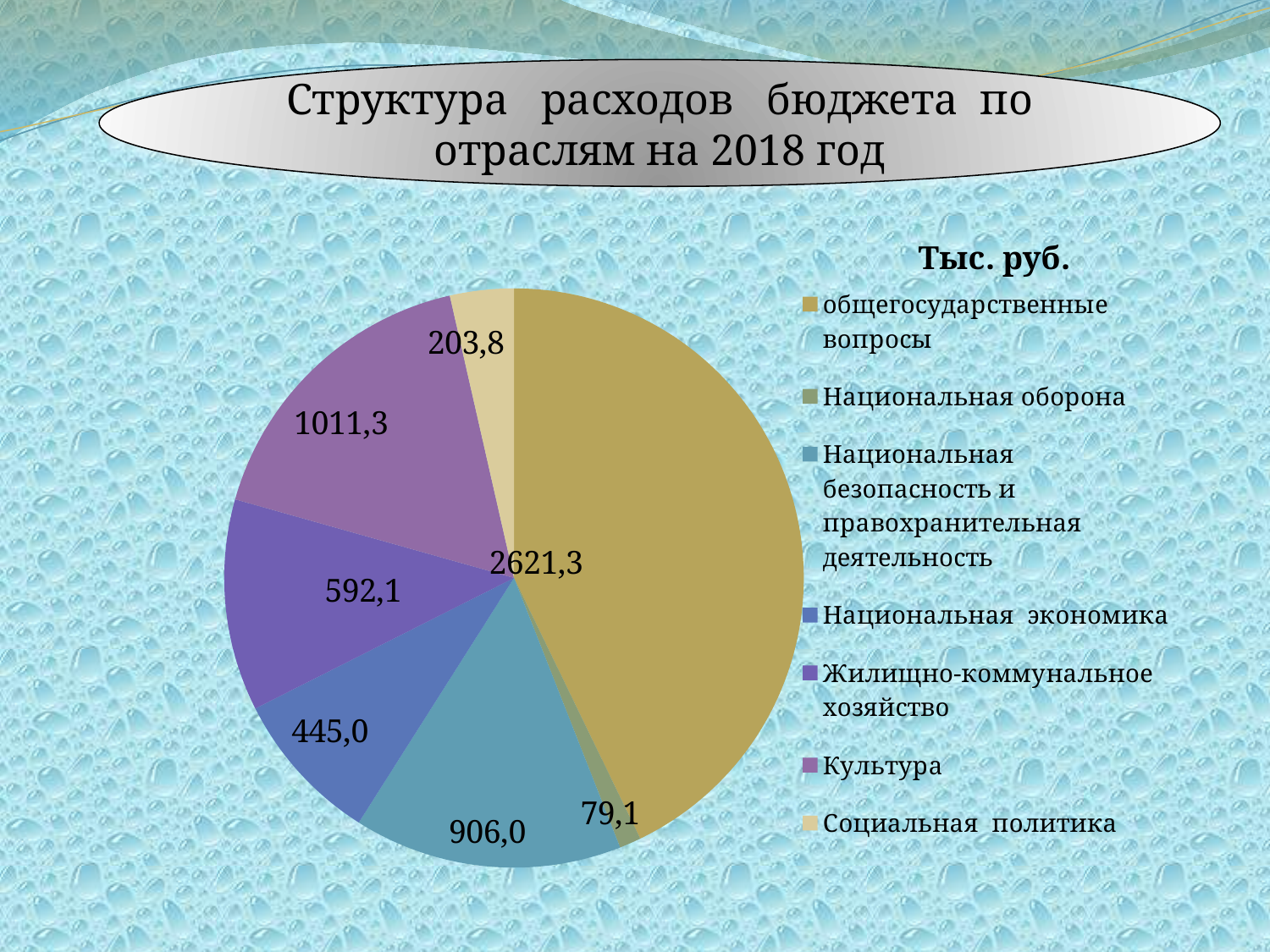
What is the value for Национальная оборона? 79,1 What is the value for Социальная политика? 203,8 Which is larger: Жилищно-коммунальное хозяйство or Национальная экономика? Жилищно-коммунальное хозяйство What is the difference between the values for Национальная безопасность и правохранительная деятельность and Национальная экономика? 461,0 What is the value for Культура? 1011,3 What kind of chart is shown on the slide? pie chart How many categories does the legend list? 7 What unit is stated above the legend? Тыс. руб. What is the value for общегосударственные вопросы? 2621,3 Which category has the smallest slice of the pie? Национальная оборона What is the difference between the values for общегосударственные вопросы and Культура? 1610,0 Which category has the largest slice of the pie? общегосударственные вопросы